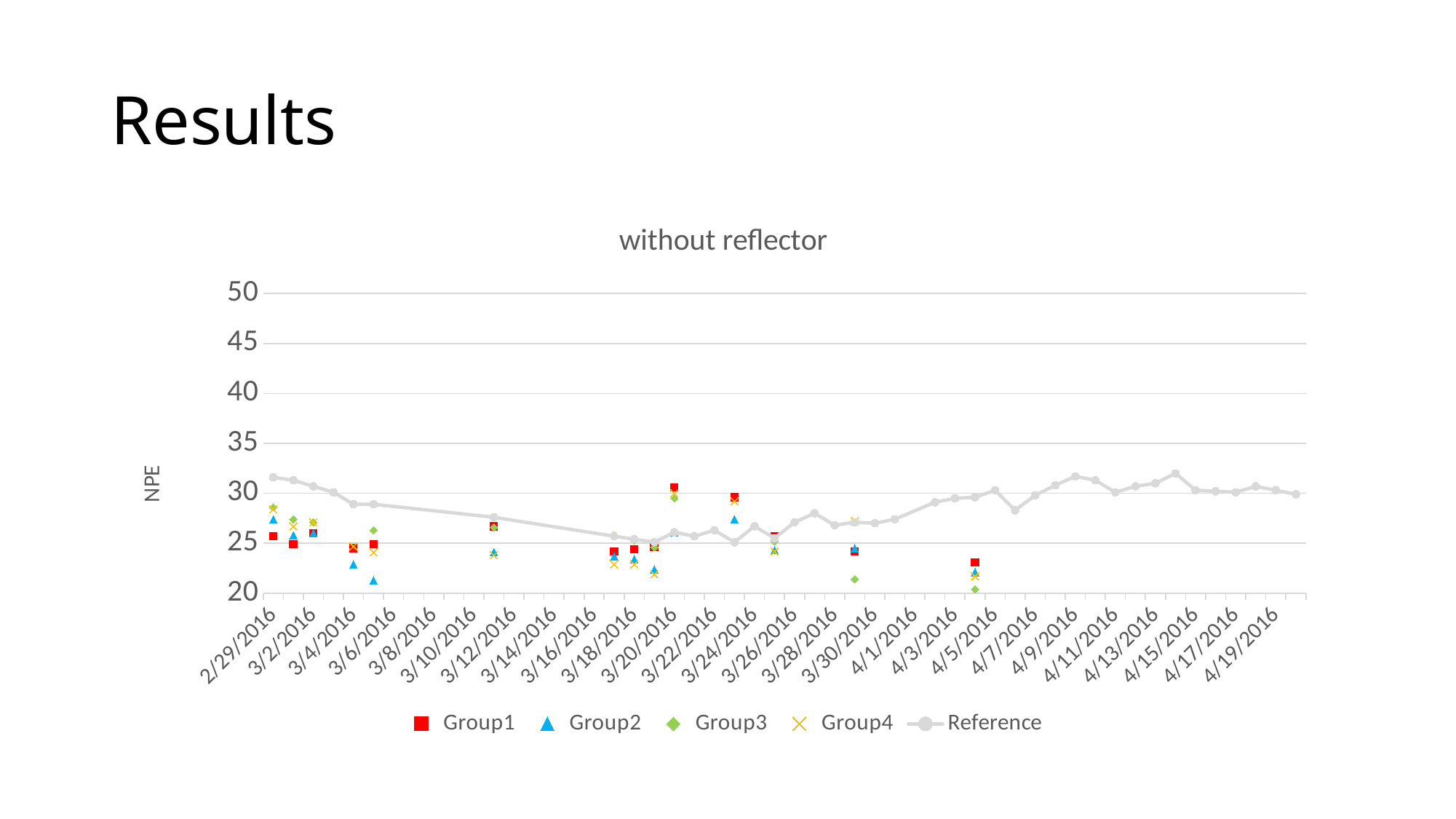
What is the title of the chart? without reflector Is the Group2 value on 3/6/2016 greater or less than 25? less Does the Reference line rise or fall between 2/29/2016 and 3/18/2016? fall What is the label on the vertical axis? NPE How many series does the legend list? 5 Does the Reference line rise or fall between 3/18/2016 and 4/9/2016? rise Which series has the lowest plotted point on the chart? Group3 On 4/5/2016, which is larger, the Group1 value or the Group3 value? Group1 Is the Group1 value on 3/20/2016 greater or less than 25? greater Is the Reference value on 2/29/2016 greater or less than 30? greater